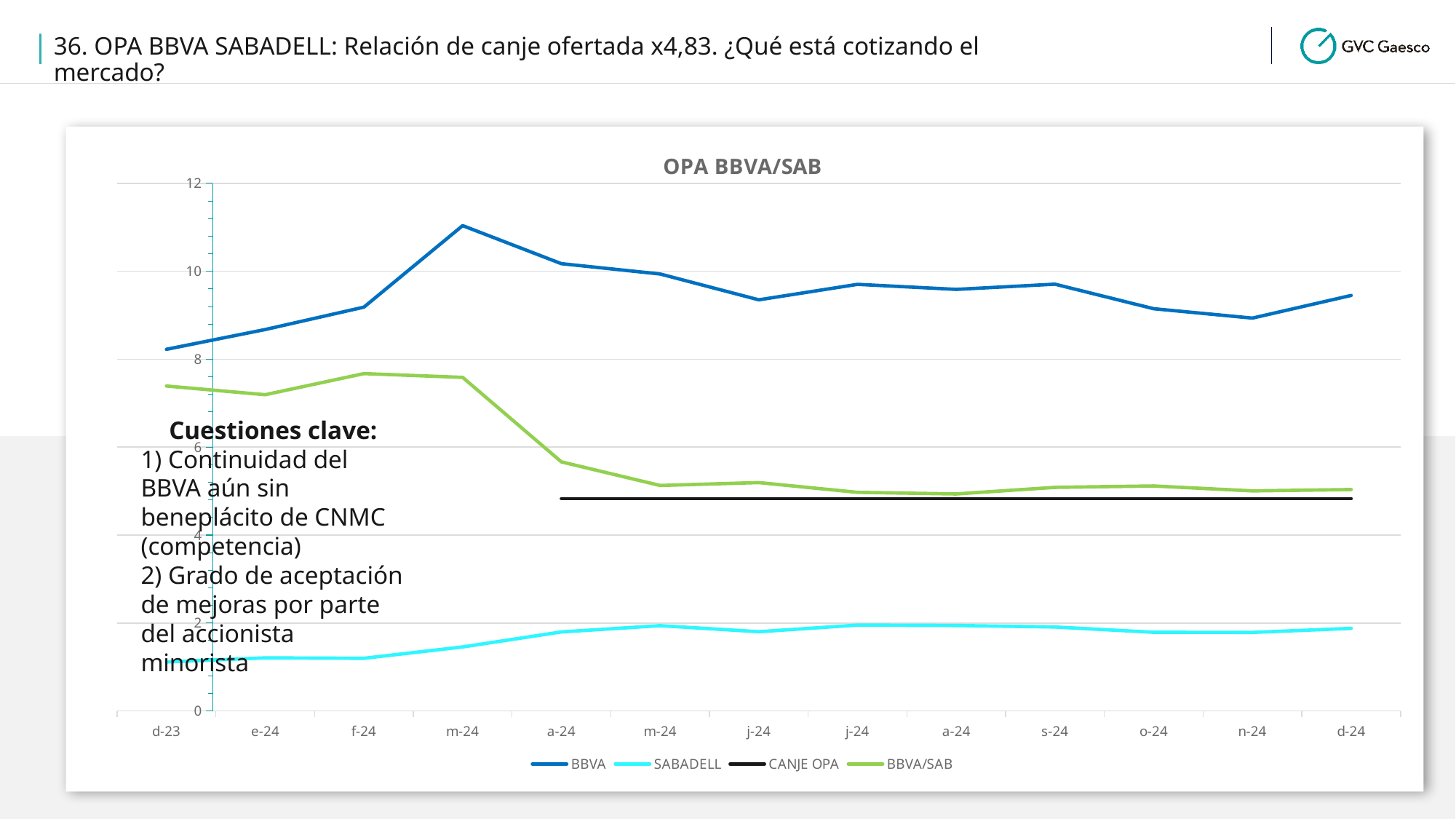
How many points are labelled on the x axis of the OPA BBVA/SAB chart? 13 What is the title of the chart? OPA BBVA/SAB Is the value of BBVA at d-23 greater or less than 8? greater At which x-axis label does the BBVA series reach its highest value? m-24 (the first one) Is the value of SABADELL at d-24 greater or less than 2? less Which is larger at d-24, the BBVA value or the SABADELL value? BBVA At which x-axis label does the BBVA series have its lowest value? d-23 What kind of chart is shown on the slide? line chart Which series is drawn as a flat black line in the chart? CANJE OPA Is the value of BBVA at n-24 greater or less than 10? less How many series does the legend of the OPA BBVA/SAB chart list? 4